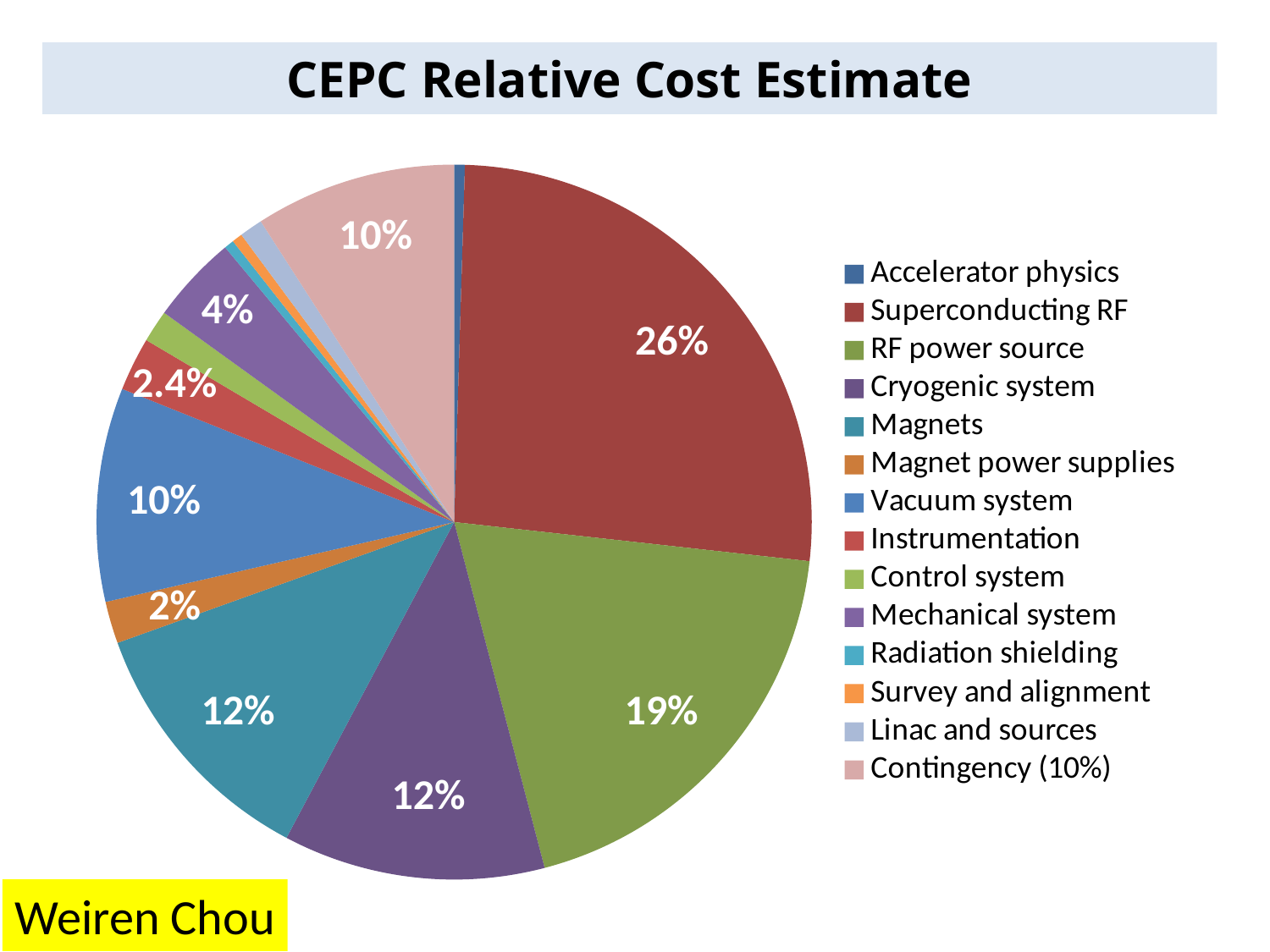
Which category has the largest share of the cost estimate? Superconducting RF What share of the cost estimate is Instrumentation? 2.4% How many categories does the legend list? 14 What share of the cost estimate is the Mechanical system? 4% What share of the cost estimate is Magnet power supplies? 2% What is the title of the chart? CEPC Relative Cost Estimate What share of the cost estimate is RF power source? 19% Which has a larger share, Cryogenic system or Vacuum system? Cryogenic system What share of the cost estimate is Superconducting RF? 26% What is the difference in percentage points between Superconducting RF and RF power source? 7% What type of chart is shown on the slide? Pie chart What share of the cost estimate is the Vacuum system? 10%